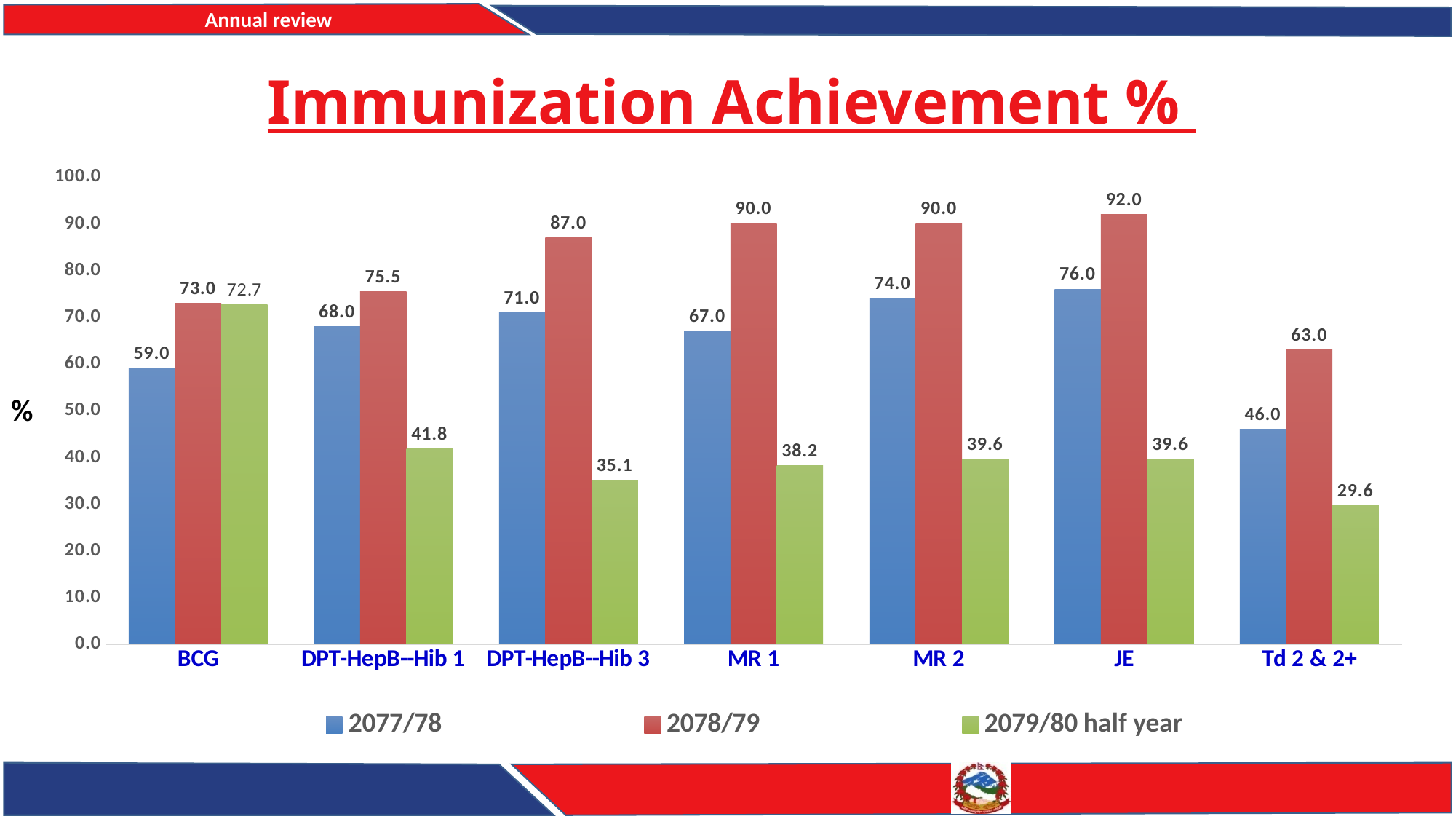
What is the 2078/79 value for JE? 92.0 What is the 2077/78 value for Td 2 & 2+? 46.0 What is the 2079/80 half year value for DPT-HepB--Hib 3? 35.1 How many series does the legend list? 3 Which category has the highest 2078/79 value? JE Which colour represents the 2079/80 half year series? Green Which is larger for BCG: the 2078/79 value or the 2079/80 half year value? 2078/79 How many categories are shown on the x axis? 7 What kind of chart is shown on the slide? Bar chart Which category has the lowest 2079/80 half year value? Td 2 & 2+ What is the title of the chart? Immunization Achievement % What is the difference between the 2078/79 and 2077/78 values for MR 1? 23.0